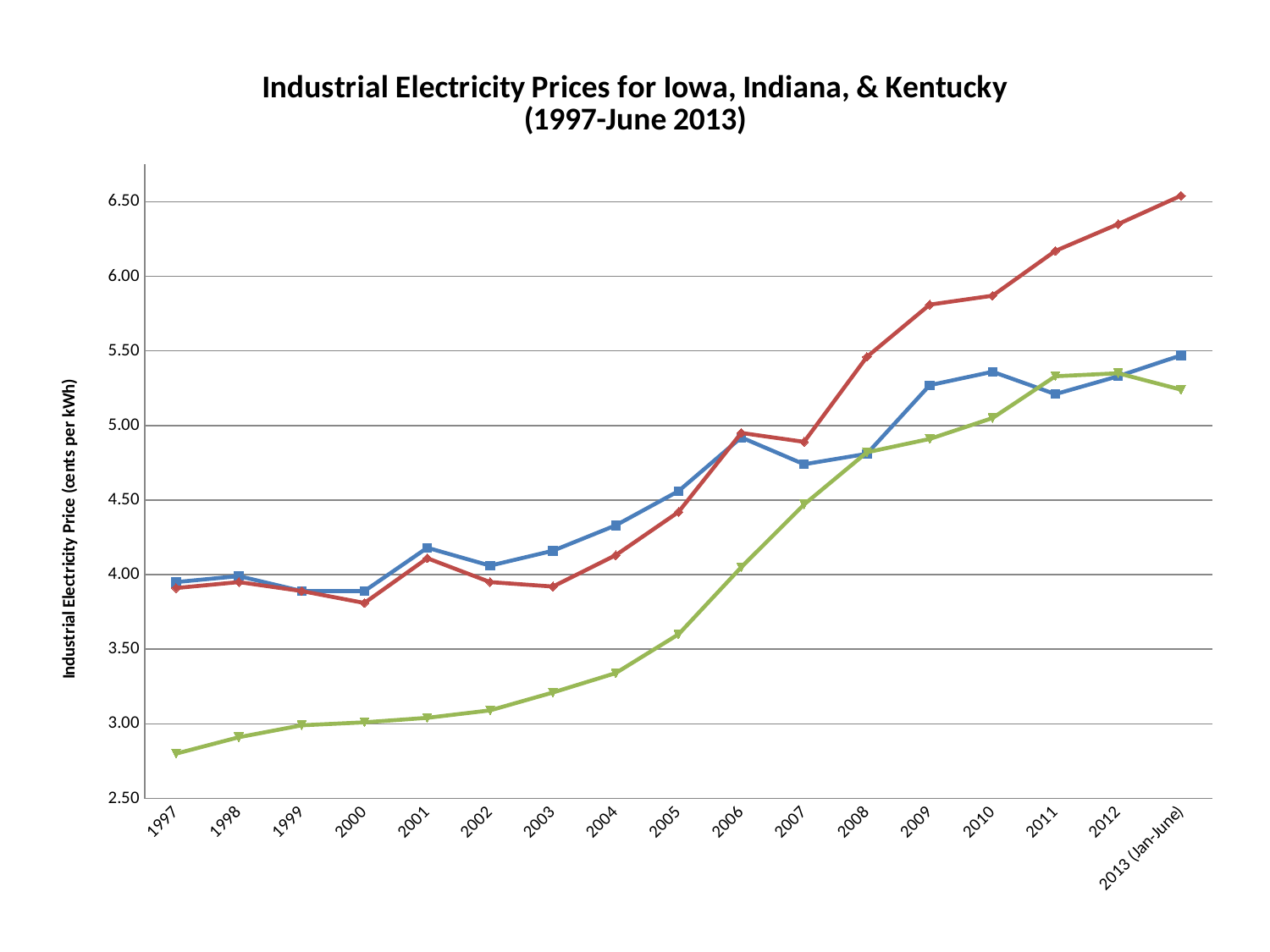
In 2010, which is higher, the red line or the blue line? the red line Is the value of the blue line for 2010 greater or less than 5.00? greater What kind of chart is shown on the slide? line chart Is the value of the green line for 1997 greater or less than 3.00? less Is the value of the green line for 2008 greater or less than 5.00? less How many time periods are shown along the x axis? 17 Does the green line generally rise or fall from 1997 to 2012? rise Which line has the highest value in 2013 (Jan-June)? the red line Which line has the lowest value in 1997? the green line What is the title of the chart? Industrial Electricity Prices for Iowa, Indiana, & Kentucky (1997-June 2013)